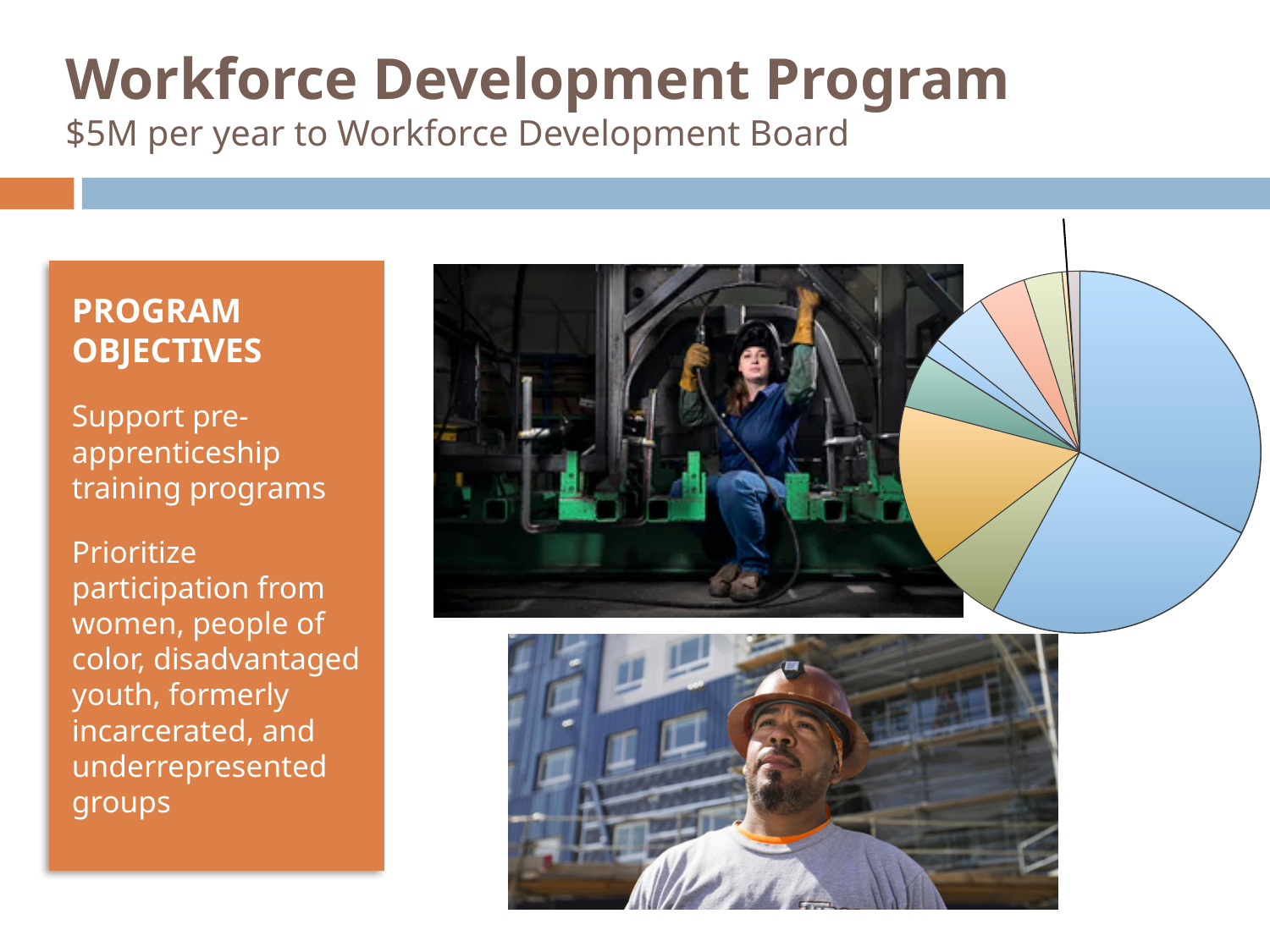
What colour is the largest slice of the pie chart? Blue Are any data labels or percentages printed on the pie chart slices? No Does the pie chart include a legend identifying its slices? No What kind of chart is shown on the right side of the slide? Pie chart